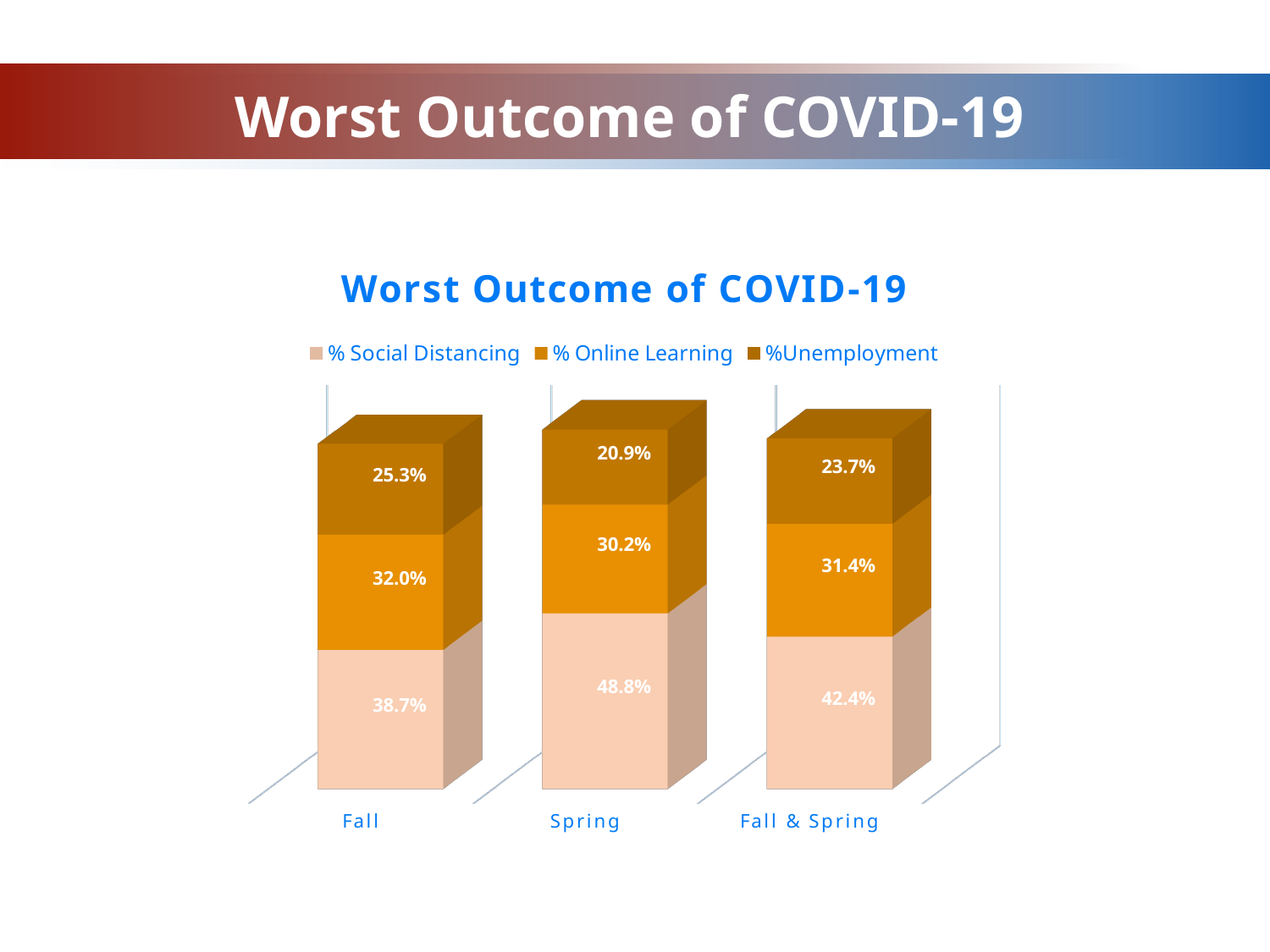
What is the title of the chart? Worst Outcome of COVID-19 What is the %Unemployment value for Fall? 25.3% What is the % Social Distancing value for Spring? 48.8% What is the total of the stacked bar for Fall? 96.0% Which category has the highest % Social Distancing value? Spring What kind of chart is shown on the slide? Stacked bar chart How many series does the legend list? 3 What is the % Online Learning value for Fall & Spring? 31.4% Which is larger, the % Online Learning value for Fall or for Spring? Fall Which category has the lowest %Unemployment value? Spring What is the difference between the % Social Distancing values for Spring and Fall? 10.1% How many categories are shown on the x axis? 3